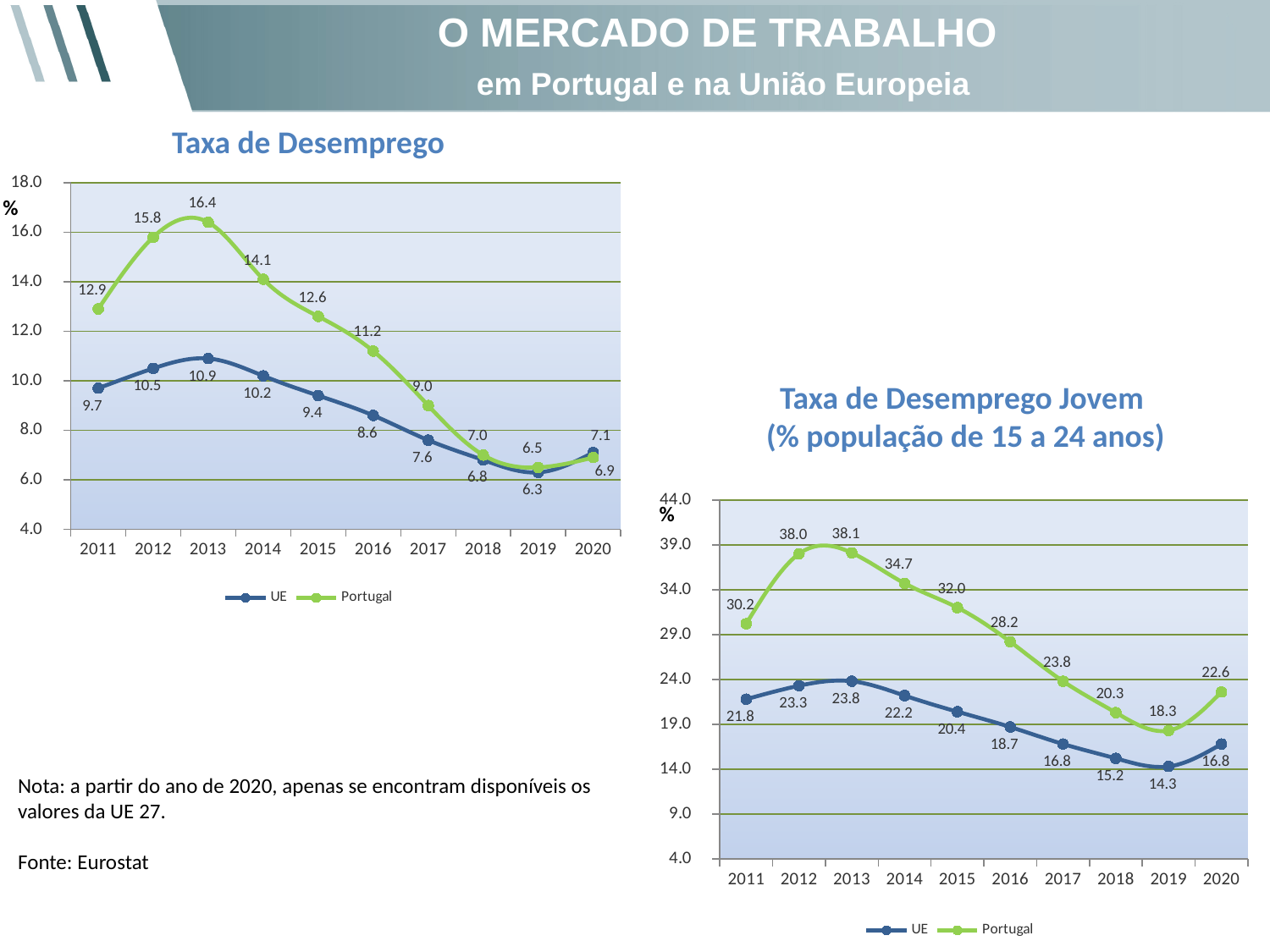
In the 'Taxa de Desemprego Jovem' chart, in which year is the UE series lowest? 2019 In the 'Taxa de Desemprego' chart, what is the value for UE in 2019? 6.3 In the 'Taxa de Desemprego' chart, how many series does the legend list? 2 In the 'Taxa de Desemprego' chart, what is the value for Portugal in 2013? 16.4 In the 'Taxa de Desemprego Jovem' chart, does the Portugal series rise or fall from 2013 to 2019? Fall In the 'Taxa de Desemprego Jovem' chart, how many years are shown on the x axis? 10 In the 'Taxa de Desemprego' chart, in which year is the Portugal series highest? 2013 In the 'Taxa de Desemprego' chart, what is the difference between Portugal and UE in 2012? 5.3 In the 'Taxa de Desemprego' chart, which series has the higher value in 2019, UE or Portugal? Portugal In the 'Taxa de Desemprego Jovem' chart, what is the value for Portugal in 2014? 34.7 In the 'Taxa de Desemprego Jovem' chart, what is the difference between Portugal and UE in 2013? 14.3 What kind of chart is 'Taxa de Desemprego Jovem'? Line chart